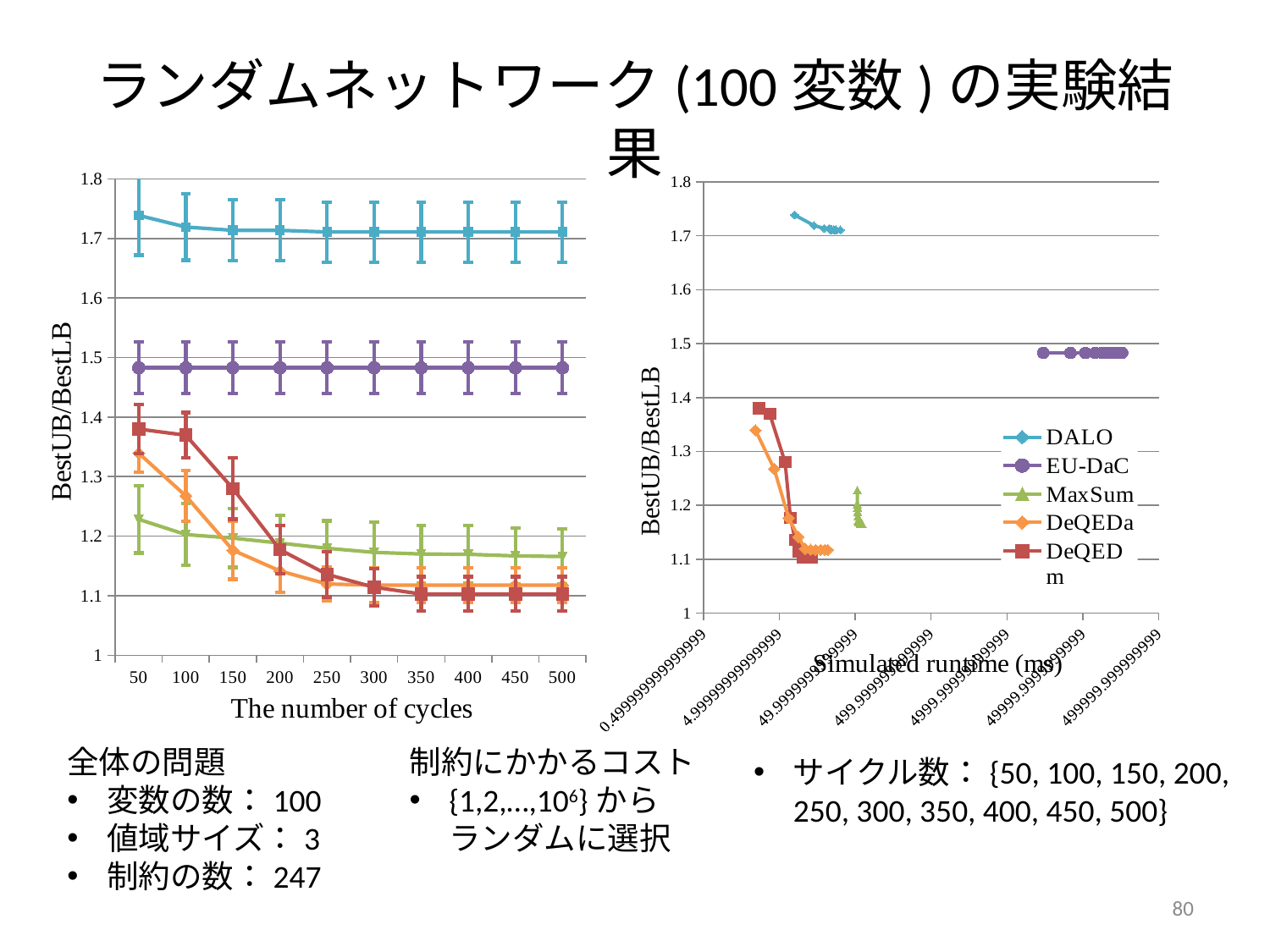
On the right chart, are the BestUB/BestLB values for DALO greater or less than 1.6? greater On the right chart, are the BestUB/BestLB values for MaxSum greater or less than 1.3? less On the right chart, are the BestUB/BestLB values for EU-DaC greater or less than 1.4? greater How many x-axis categories (cycle counts) are plotted on the left chart? 10 On the left chart, does the red line rise or fall as the number of cycles increases? fall What kind of chart is the left chart (BestUB/BestLB vs. The number of cycles)? line chart On the right chart, which series has the highest BestUB/BestLB values? DALO What is the x-axis title of the right chart? Simulated runtime (ms) How many series does the legend of the right chart list? 5 What is the x-axis title of the left chart? The number of cycles